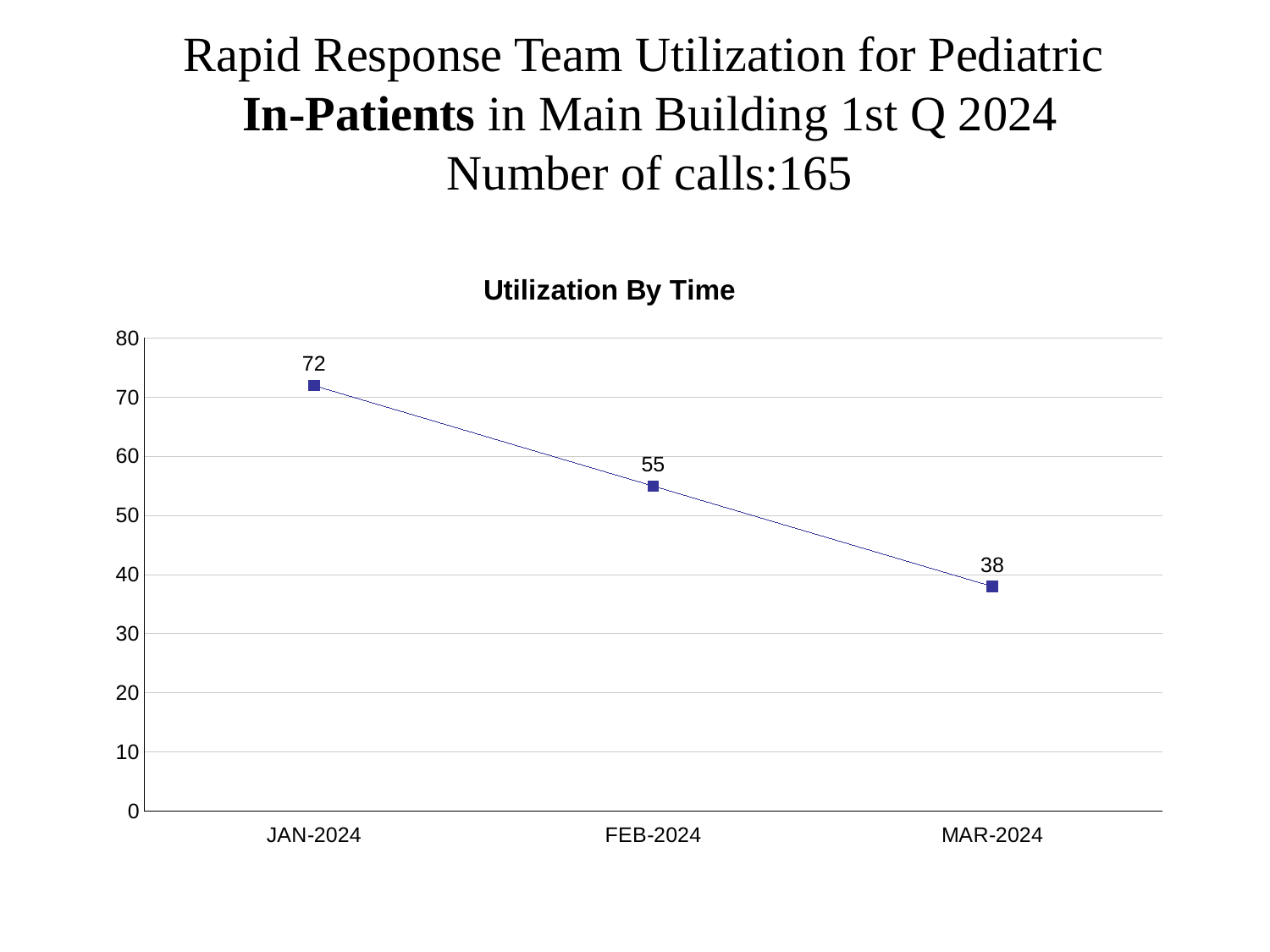
What is the value for JAN-2024? 72 How many data points are plotted on the chart? 3 Which month has the lowest value? MAR-2024 Is the value for FEB-2024 greater or less than 60? less Which is larger, the value for FEB-2024 or the value for MAR-2024? FEB-2024 What is the difference between the values for JAN-2024 and MAR-2024? 34 Which month has the highest value? JAN-2024 What kind of chart is shown on the slide? line chart What is the difference between the values for JAN-2024 and FEB-2024? 17 Do the values rise or fall from JAN-2024 to MAR-2024? fall What is the value for MAR-2024? 38 What is the value for FEB-2024? 55